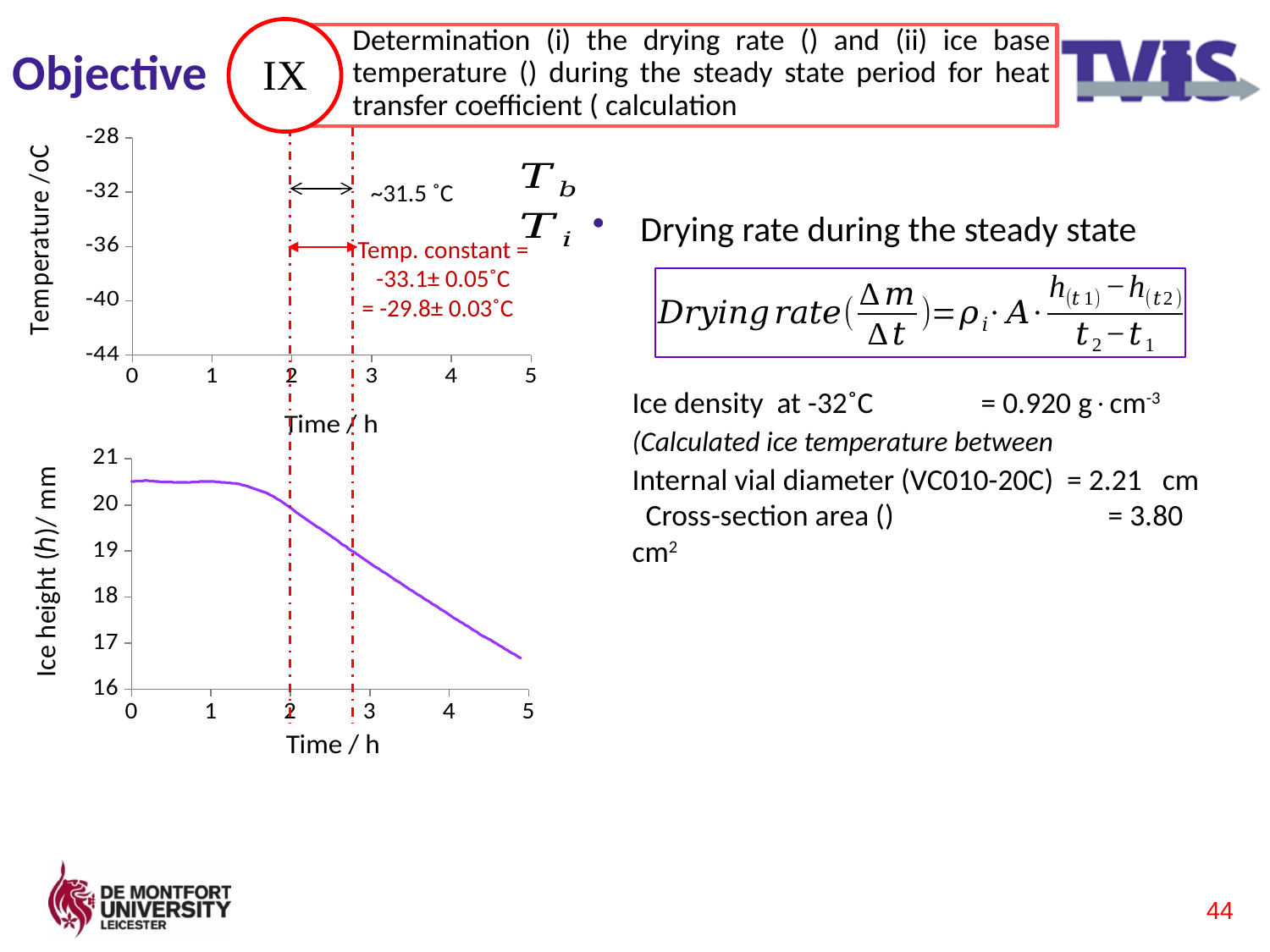
What kind of chart is the bottom chart (Ice height vs Time)? line chart What is the y-axis label of the bottom chart? Ice height (h)/ mm In the bottom chart (Ice height vs Time), at which time is the ice height lowest: 0 h, 2 h, or the end of the curve near 5 h? near 5 h What is the x-axis label shared by both charts? Time / h In the bottom chart (Ice height vs Time), does the ice height rise or fall as time increases from 1 h to 5 h? fall In the bottom chart (Ice height vs Time), is the ice height at time 0 h greater or less than 20 mm? greater In the bottom chart (Ice height vs Time), which is larger: the ice height at 1 h or the ice height at 4 h? 1 h In the bottom chart (Ice height vs Time), is the ice height at the end of the curve (near 5 h) greater or less than 17 mm? less What is the y-axis label of the top chart? Temperature /oC In the bottom chart (Ice height vs Time), is the ice height at time 4 h greater or less than 18 mm? less